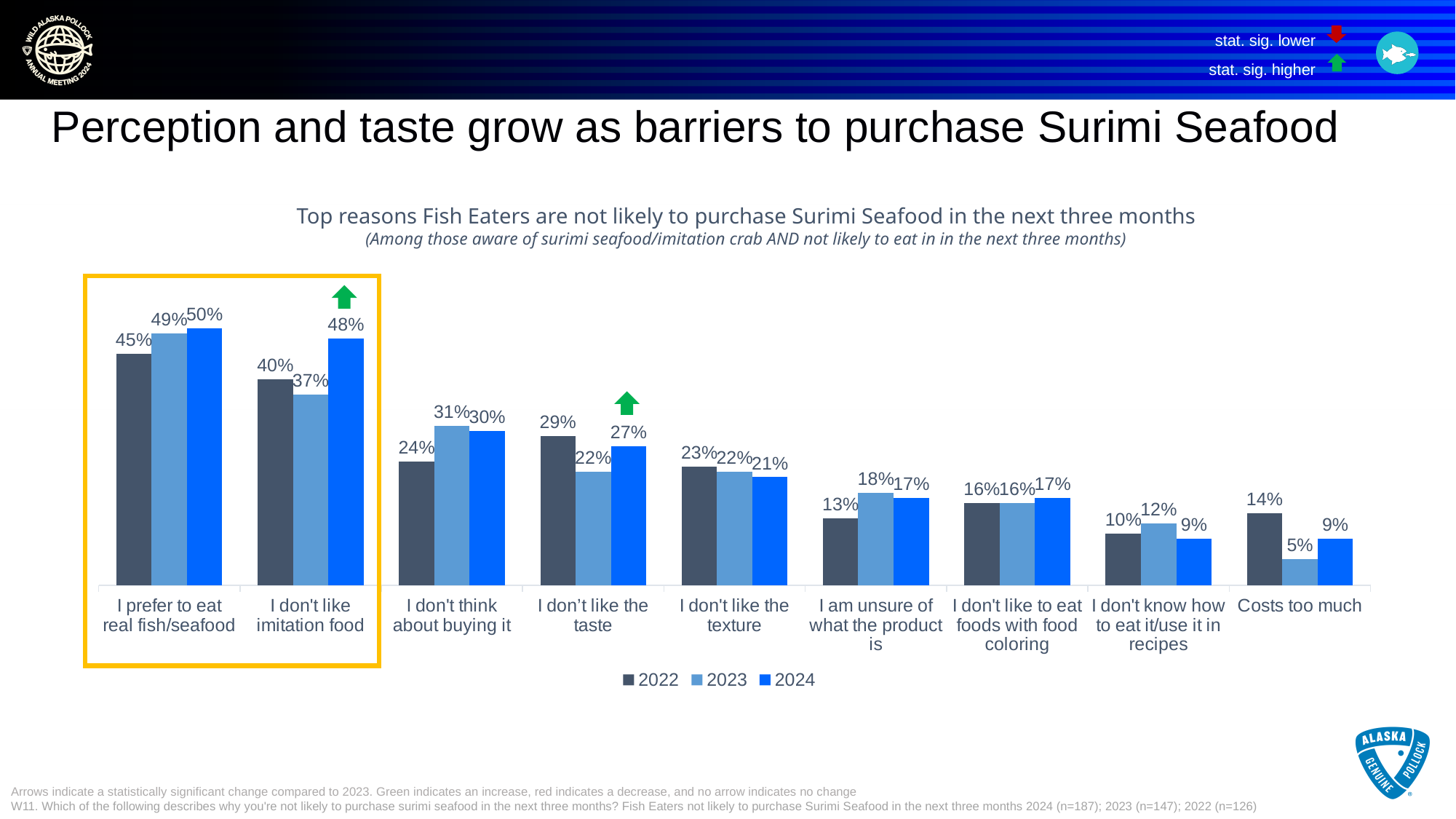
What is the 2023 value for "I don't like imitation food"? 37% Which two categories are marked with a green arrow indicating a statistically significant increase? I don't like imitation food; I don't like the taste What is the difference between the 2024 and 2023 values for "I don't like imitation food"? 11 percentage points Which category has the lowest 2023 value? Costs too much How many series does the legend list? 3 What kind of chart is shown on the slide? Bar chart What is the 2023 value for "Costs too much"? 5% Which is larger for "I don't like the texture": the 2022 value or the 2024 value? 2022 What is the 2024 value for "I prefer to eat real fish/seafood"? 50% What is the 2022 value for "I don't like the taste"? 29% Which category has the highest 2024 value? I prefer to eat real fish/seafood How many reason categories are shown on the x axis? 9